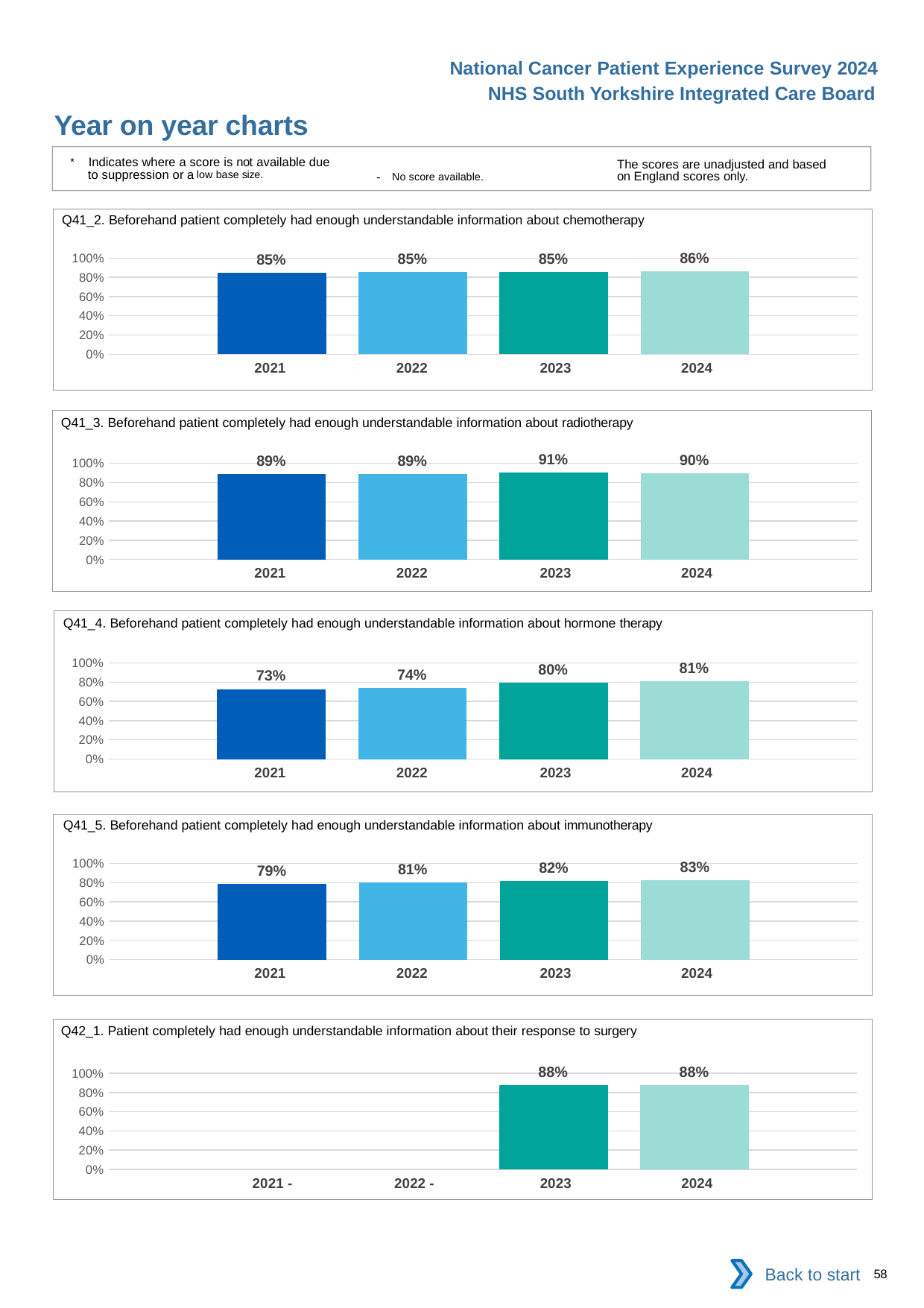
In the Q41_3 chart (radiotherapy), what is the value for 2021? 89% How many charts are shown on the slide? 5 In the Q41_4 chart (hormone therapy), is the value for 2023 greater or less than the value for 2022? greater In the Q41_4 chart (hormone therapy), what is the difference between the 2024 and 2021 values? 8 percentage points In the Q42_1 chart (response to surgery), what is the value for 2023? 88% In the Q41_2 chart (chemotherapy), what is the value for 2024? 86% What type of chart is the Q41_2 chart (chemotherapy)? bar chart In the Q41_4 chart (hormone therapy), which year has the lowest value? 2021 In the Q42_1 chart (response to surgery), how many years have a bar plotted? 2 In the Q41_3 chart (radiotherapy), which year has the highest value? 2023 In the Q41_5 chart (immunotherapy), do the values rise or fall from 2021 to 2024? rise In the Q41_5 chart (immunotherapy), what is the value for 2022? 81%